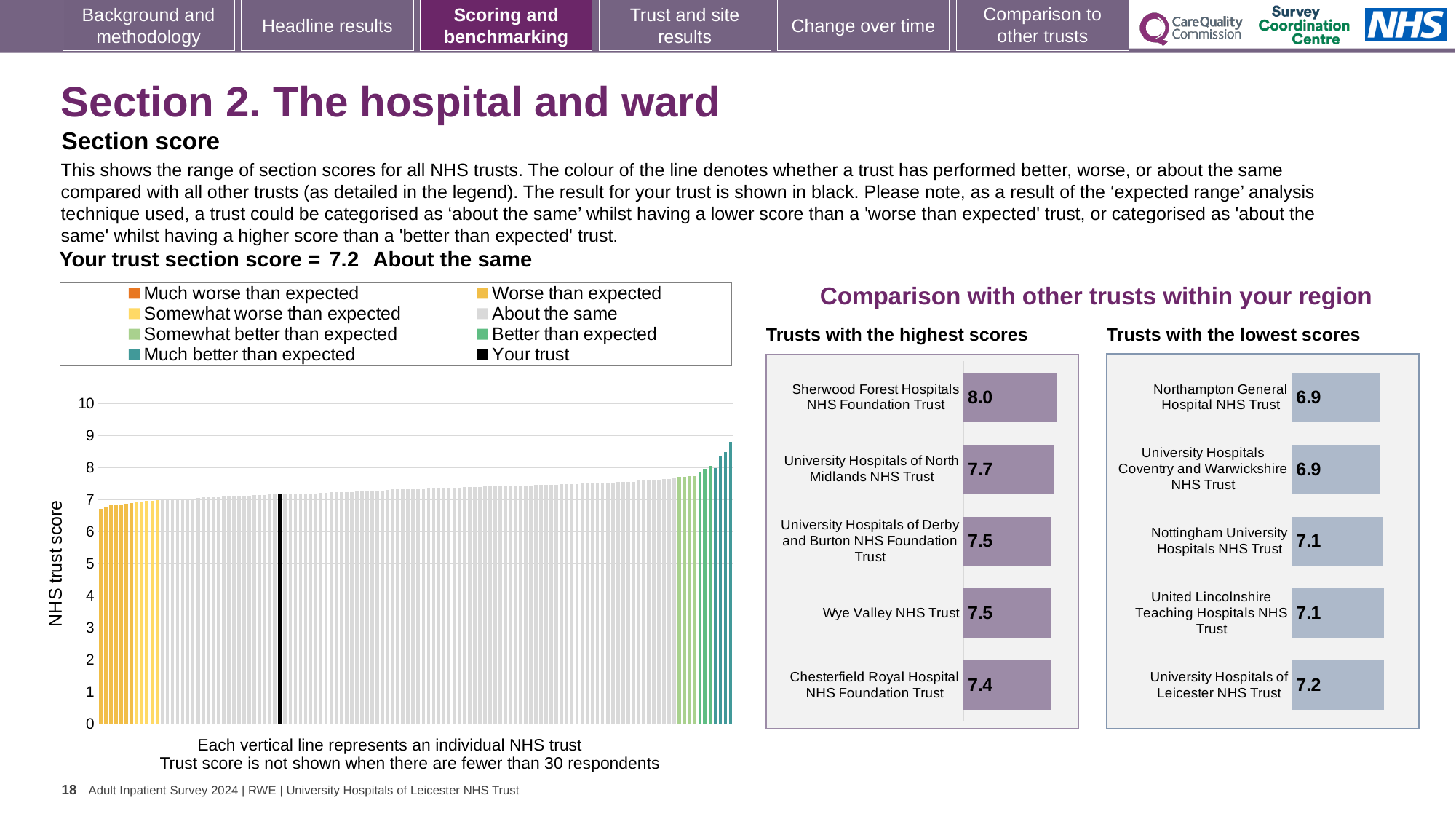
In the 'Trusts with the lowest scores' chart, what is the score for University Hospitals of Leicester NHS Trust? 7.2 In the 'Trusts with the lowest scores' chart, which trust has the highest score shown? University Hospitals of Leicester NHS Trust In the 'Trusts with the lowest scores' chart, which has the larger score: Northampton General Hospital NHS Trust or United Lincolnshire Teaching Hospitals NHS Trust? United Lincolnshire Teaching Hospitals NHS Trust In the 'Trusts with the highest scores' chart, which trust has the highest score? Sherwood Forest Hospitals NHS Foundation Trust In the 'Trusts with the highest scores' chart, what is the score for Sherwood Forest Hospitals NHS Foundation Trust? 8.0 In the 'Trusts with the lowest scores' chart, what is the score for Nottingham University Hospitals NHS Trust? 7.1 In the main 'NHS trust score' chart on the left, do the values rise or fall from left to right? rise In the main 'NHS trust score' chart on the left, is the value of the rightmost bar greater or less than 8? greater How many entries does the legend of the main 'NHS trust score' chart list? 8 How many trusts are listed in the 'Trusts with the highest scores' chart? 5 In the 'Trusts with the highest scores' chart, what is the difference between the scores of Sherwood Forest Hospitals NHS Foundation Trust and University Hospitals of North Midlands NHS Trust? 0.3 In the 'Trusts with the highest scores' chart, what is the score for Chesterfield Royal Hospital NHS Foundation Trust? 7.4